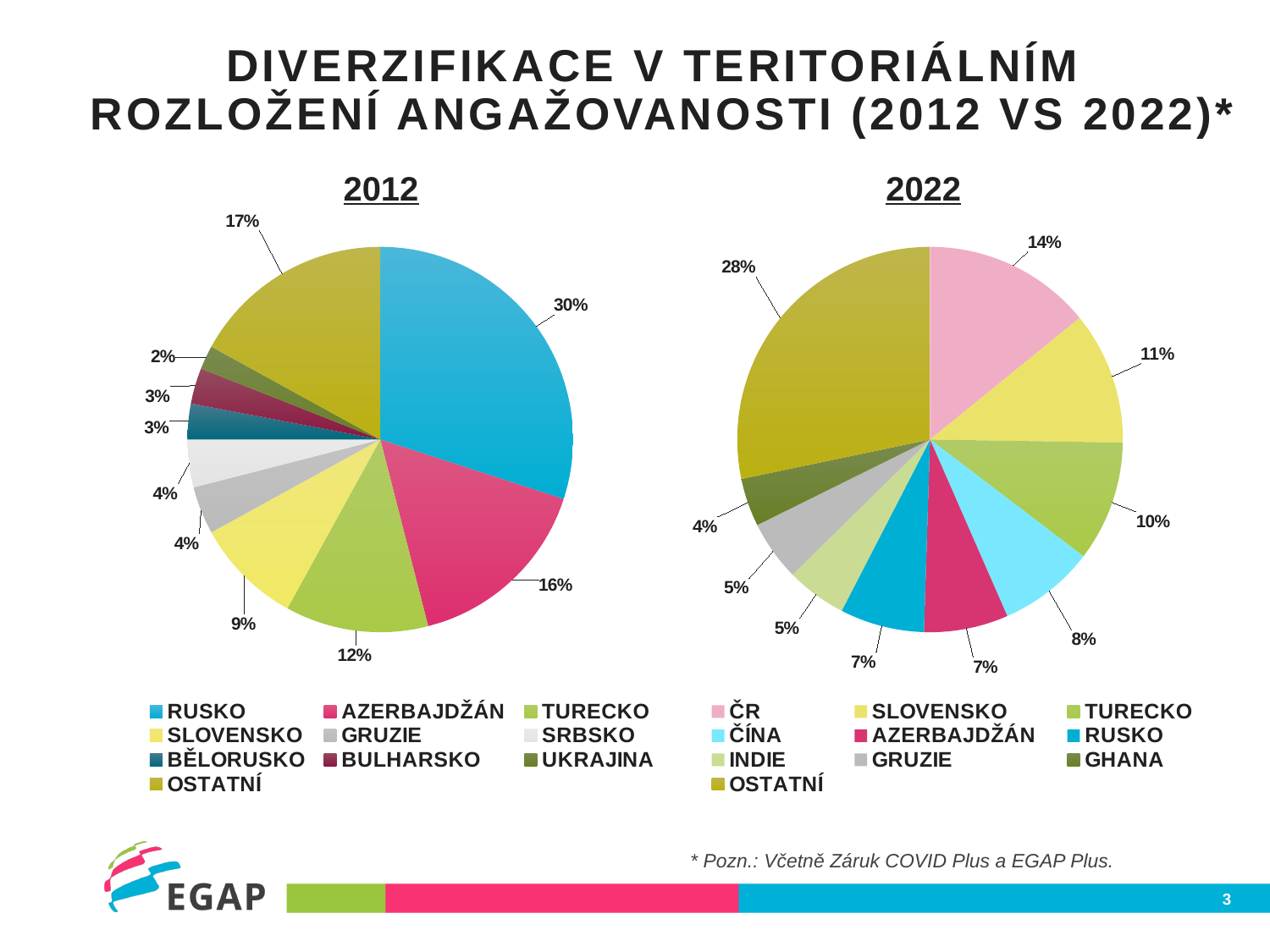
In the 2022 pie chart, what share does ČR have? 14% In the 2012 pie chart, which category has the smallest share? UKRAJINA In the 2012 pie chart, what share does TURECKO have? 12% In the 2012 pie chart, what share does RUSKO have? 30% What kind of chart is used for the 2012 data? Pie chart In the 2012 pie chart, which named country has the largest share? RUSKO In the 2022 pie chart, which category has the smallest share? GHANA In the 2022 pie chart, which is larger: the share of SLOVENSKO or the share of ČÍNA? SLOVENSKO How many categories does the 2022 pie chart show? 10 In the 2022 pie chart, what share does OSTATNÍ have? 28% In the 2022 pie chart, which category has the largest share? OSTATNÍ What is the difference between the share of RUSKO in the 2012 chart and the share of RUSKO in the 2022 chart? 23 percentage points